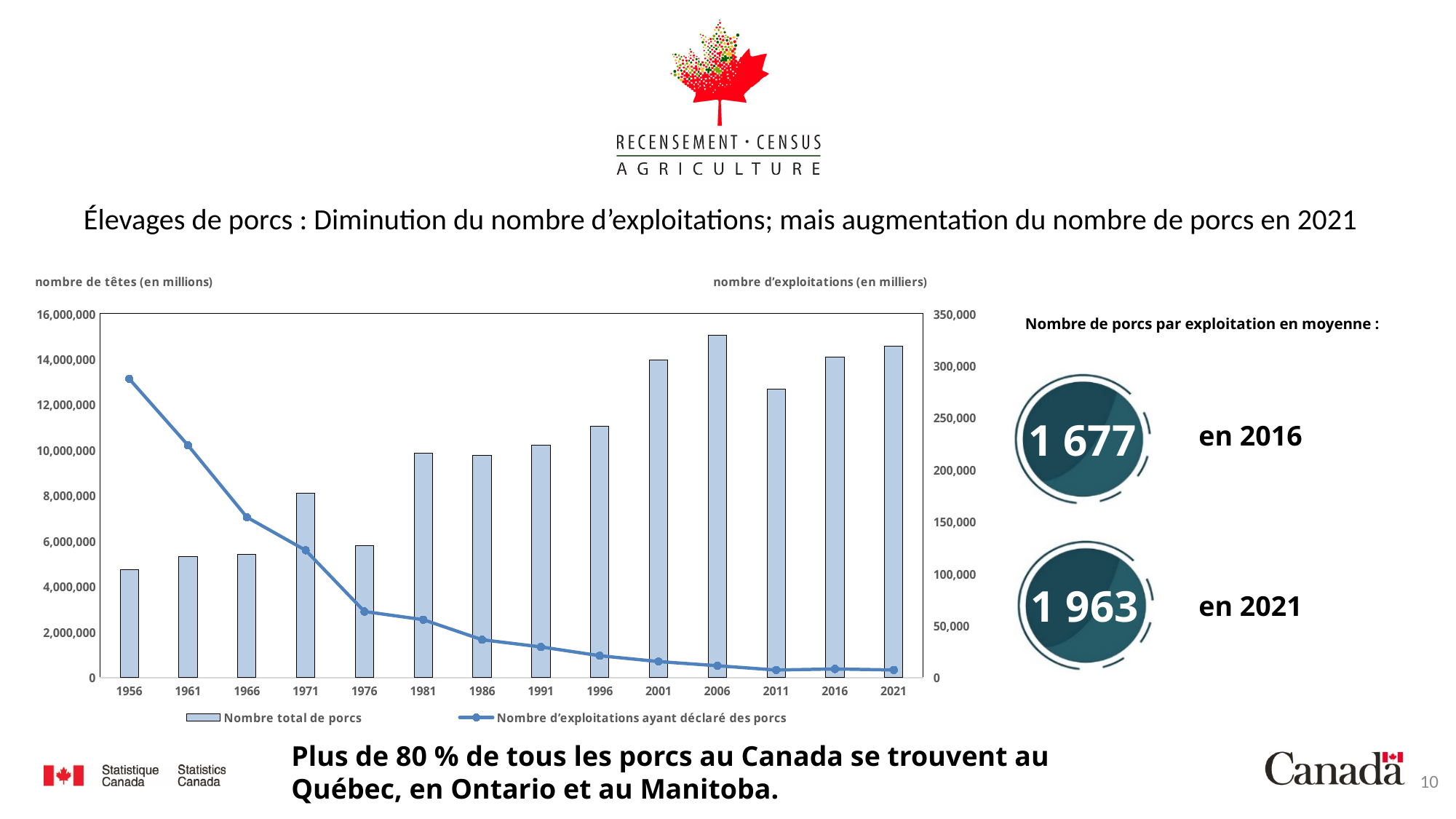
Is the value of the line 'Nombre d'exploitations ayant déclaré des porcs' in 1956 greater or less than 250,000? greater Which year has the larger bar for 'Nombre total de porcs', 2011 or 2016? 2016 How many years are shown on the x axis of the chart? 14 Is the bar for 'Nombre total de porcs' in 2006 greater or less than 14,000,000? greater What kind of chart is shown on the slide? Combined bar and line chart How many series does the chart legend list? 2 What is the label of the left vertical axis of the chart? nombre de têtes (en millions) Does the number of farms reporting pigs (the line) rise or fall from 1956 to 2021? Fall In which year is the line 'Nombre d'exploitations ayant déclaré des porcs' at its highest? 1956 In which year is the bar for 'Nombre total de porcs' the lowest? 1956 In which year is the bar for 'Nombre total de porcs' the highest? 2006